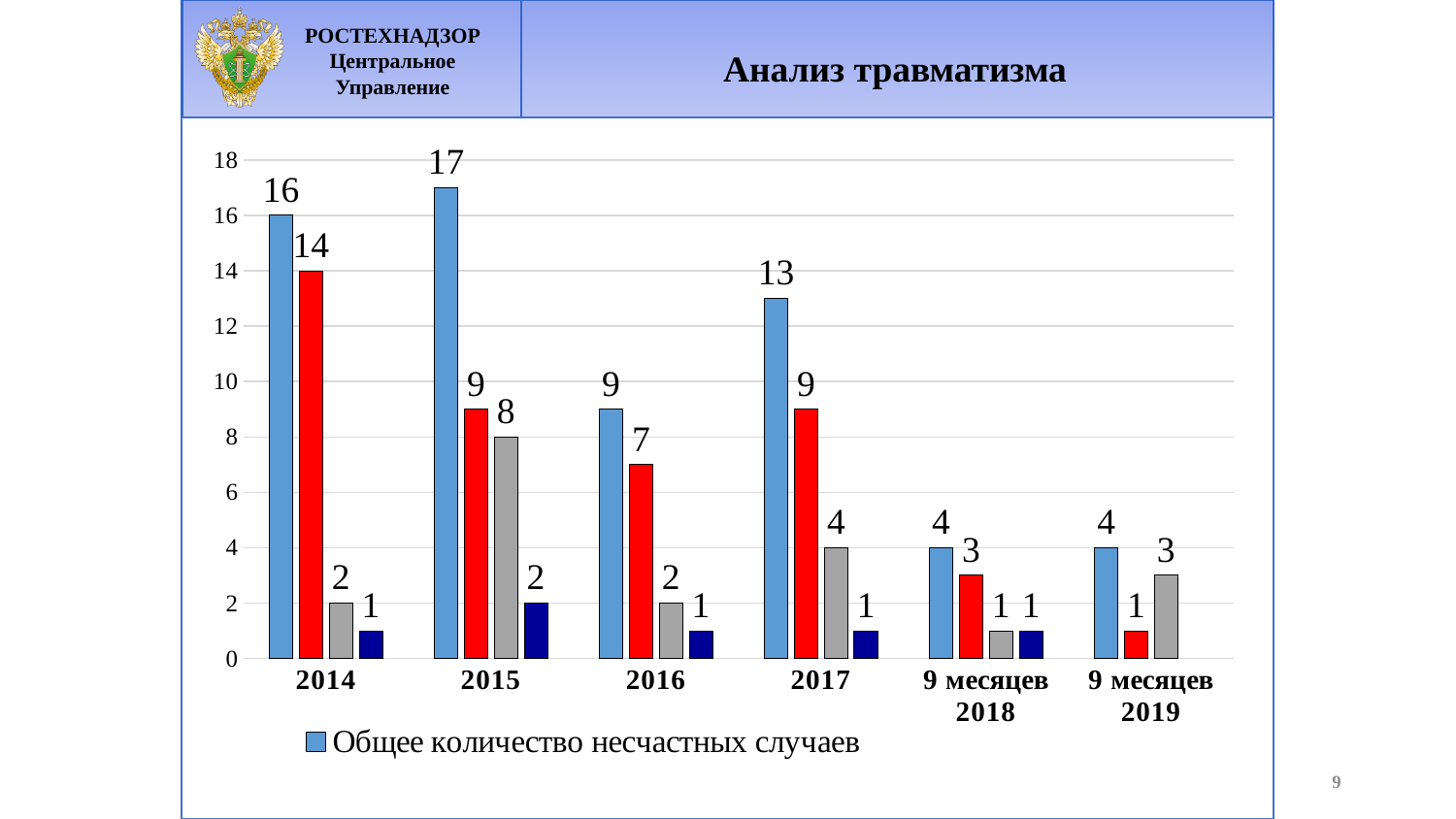
Does 'Общее количество несчастных случаев' rise or fall from 2017 to 9 месяцев 2018? Fall How many series does the legend list? 1 What is the title of the slide containing the chart? Анализ травматизма What is the difference between 'Общее количество несчастных случаев' in 2015 and in 2016? 8 What is the value of the red bar for 2014? 14 What kind of chart is shown on the slide? Bar chart Which category has the lowest red bar value? 9 месяцев 2019 What is the value of 'Общее количество несчастных случаев' for 2015? 17 How many categories are shown on the x axis? 6 What is the value of the gray bar for 2017? 4 In which year is 'Общее количество несчастных случаев' highest? 2015 Which is larger: the red bar for 2016 or the red bar for 2017? 2017